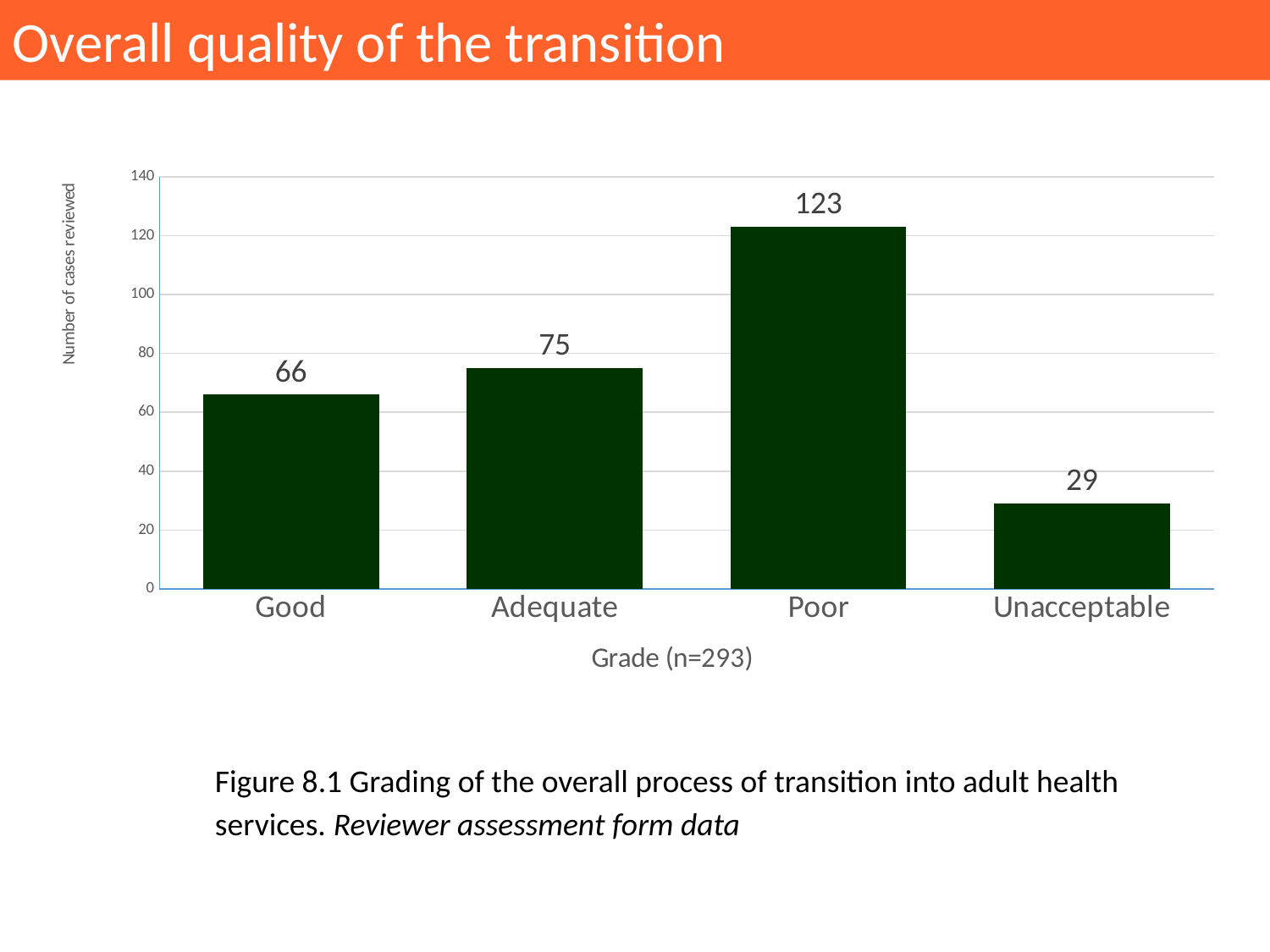
Is the value for Poor greater or less than 120? greater Which grade has the highest number of cases? Poor How many cases were graded Unacceptable? 29 What kind of chart is shown on the slide? bar chart Which has more cases, Good or Adequate? Adequate Which grade has the lowest number of cases? Unacceptable How many grade categories are shown on the x axis? 4 How many cases were graded Good? 66 What is the difference between the number of cases graded Poor and the number graded Adequate? 48 What is the label of the x axis? Grade (n=293) What is the label of the y axis? Number of cases reviewed How many cases were graded Poor? 123